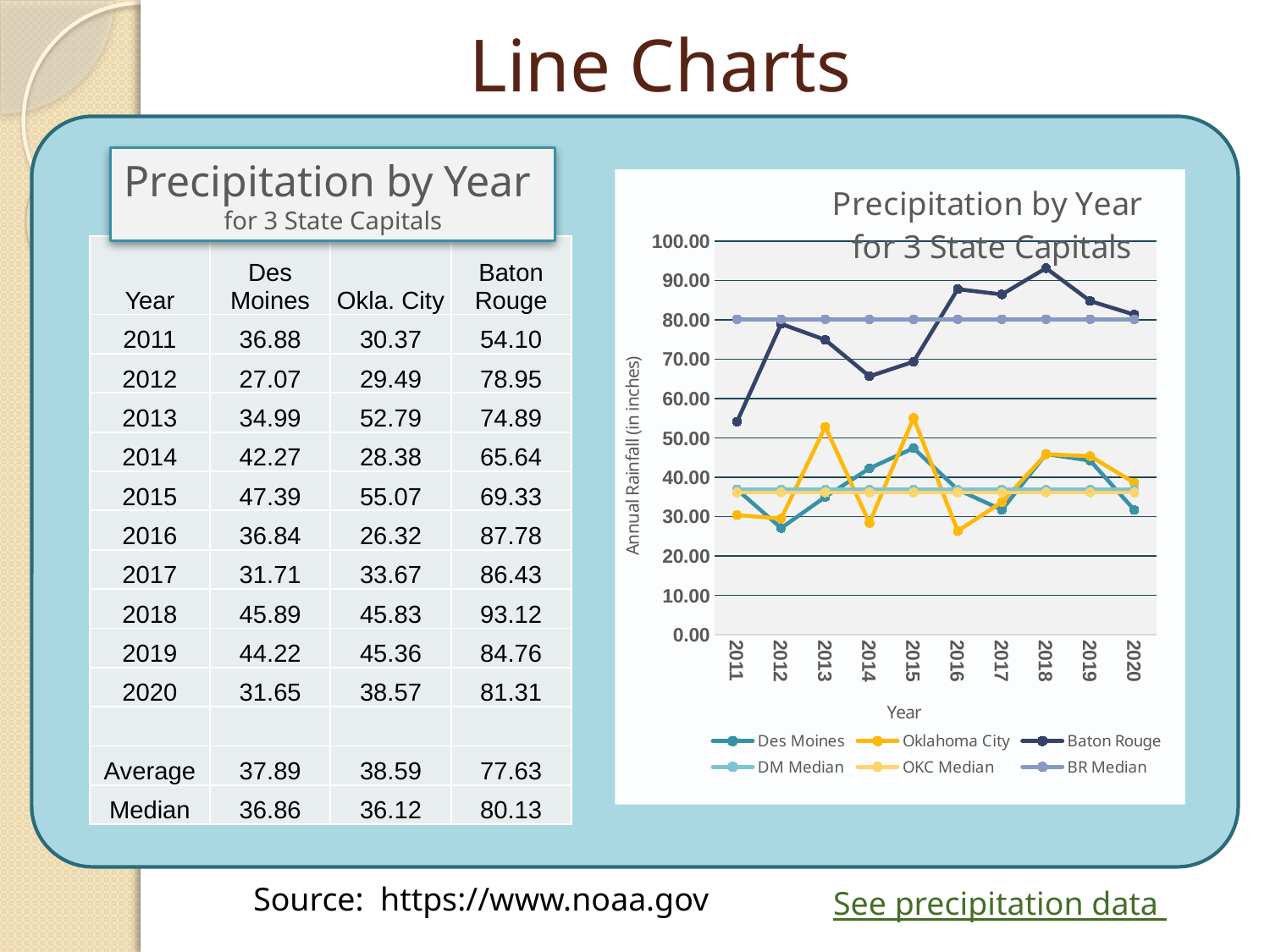
In which year does the Baton Rouge line reach its highest value? 2018 In 2013, which is larger: the Oklahoma City value or the Des Moines value? Oklahoma City How many series does the chart's legend list? 6 What is the label on the chart's vertical axis? Annual Rainfall (in inches) What kind of chart is shown on the slide? line chart Is the Baton Rouge value for 2011 greater or less than 60.00? less How many years are plotted along the x axis of the chart? 10 What is the difference between the Baton Rouge values for 2012 and 2011? 24.85 Does the Des Moines line rise or fall from 2018 to 2020? fall In which year does the Oklahoma City line reach its lowest value? 2016 What is the Baton Rouge precipitation value for 2018? 93.12 Is the Des Moines value for 2015 greater or less than 40.00? greater